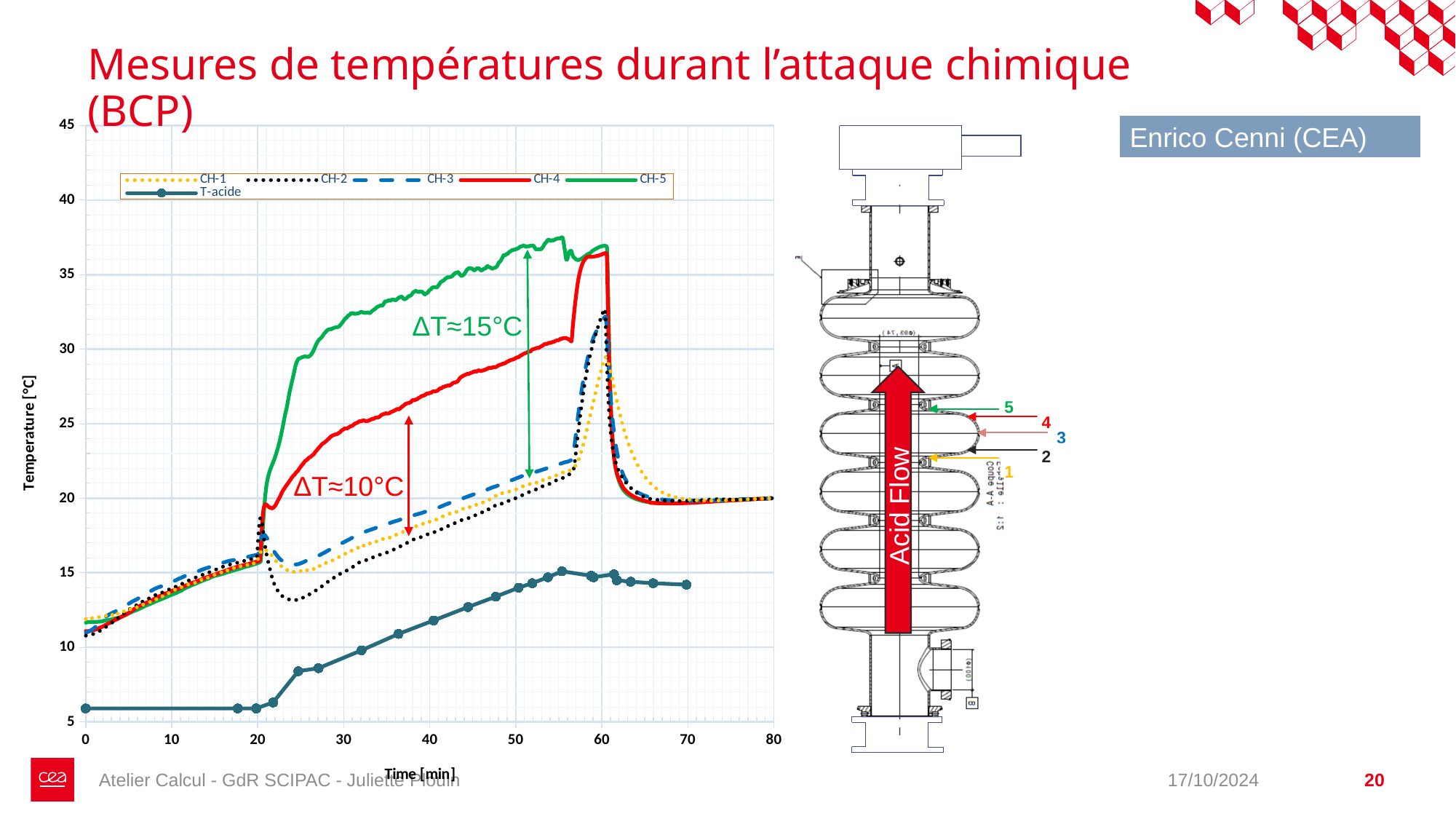
Does the T-acide series rise or fall between 20 min and 55 min? rise Is the value for T-acide at 0 min greater or less than 10? less What kind of chart is shown on the slide? line chart How many series does the chart legend list? 6 Is the value for T-acide at 70 min greater or less than 20? less Is the value for CH-4 at 40 min greater or less than 25? greater At 40 min, which is larger, CH-4 or CH-3? CH-4 What is the label of the x axis of the chart? Time [min] Which series has the highest temperature at 40 min? CH-5 What is the label of the y axis of the chart? Temperature [°C] Which series has the lowest temperature values across the whole time range? T-acide